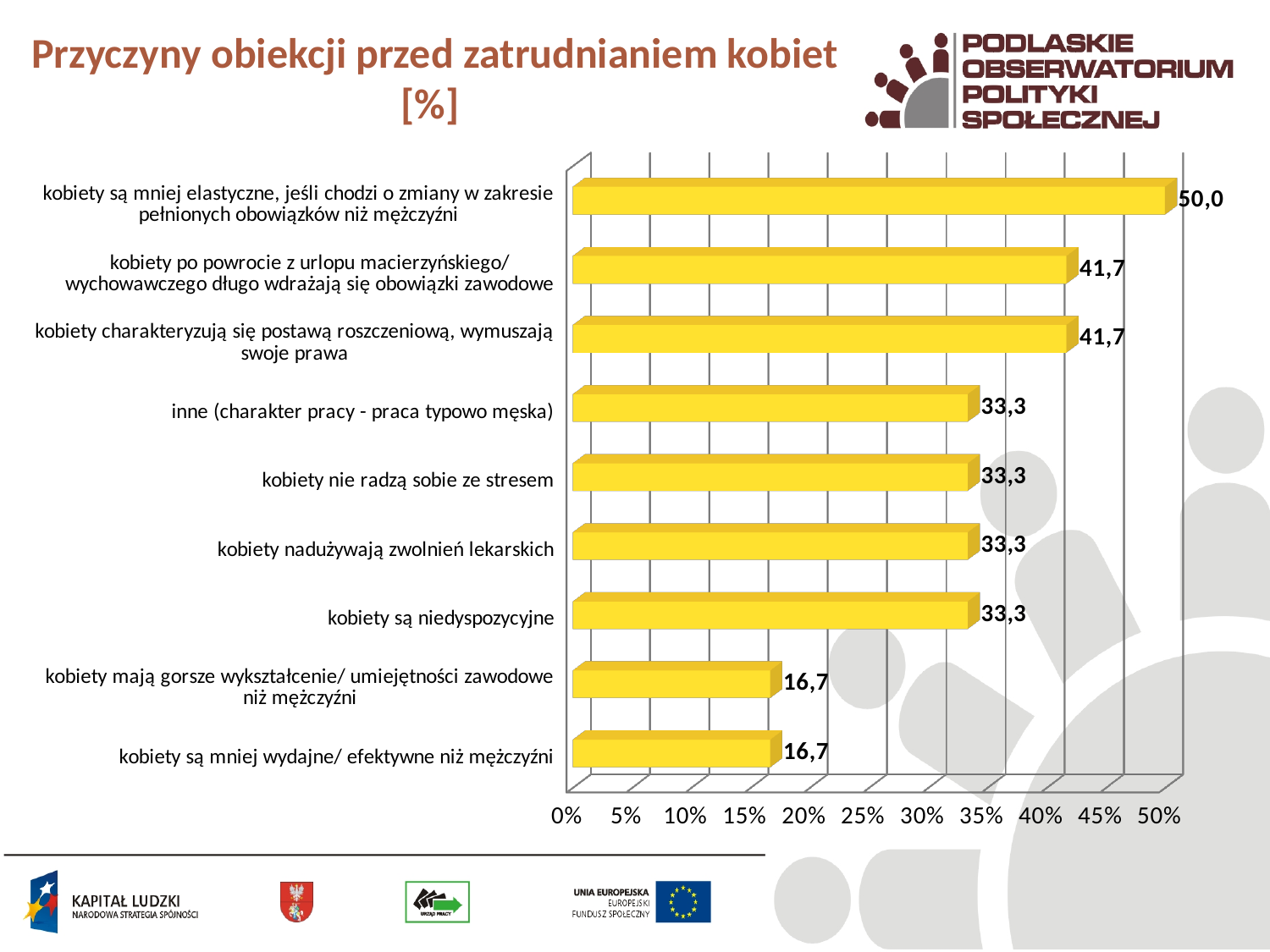
What is the value for "kobiety nie radzą sobie ze stresem"? 33,3 How many categories are shown in the chart? 9 What kind of chart is shown on the slide? bar chart Which is larger: the value for "inne (charakter pracy - praca typowo męska)" or the value for "kobiety są mniej wydajne/ efektywne niż mężczyźni"? inne (charakter pracy - praca typowo męska) Which category has the highest value? kobiety są mniej elastyczne, jeśli chodzi o zmiany w zakresie pełnionych obowiązków niż mężczyźni What is the difference between the value for "kobiety po powrocie z urlopu macierzyńskiego/ wychowawczego długo wdrażają się obowiązki zawodowe" and the value for "kobiety mają gorsze wykształcenie/ umiejętności zawodowe niż mężczyźni"? 25,0 What is the value for "kobiety są mniej elastyczne, jeśli chodzi o zmiany w zakresie pełnionych obowiązków niż mężczyźni"? 50,0 What is the difference between the value for "kobiety są mniej elastyczne, jeśli chodzi o zmiany w zakresie pełnionych obowiązków niż mężczyźni" and the value for "kobiety są niedyspozycyjne"? 16,7 Is the value for "kobiety nadużywają zwolnień lekarskich" greater or less than 30%? greater What is the value for "kobiety charakteryzują się postawą roszczeniową, wymuszają swoje prawa"? 41,7 What is the value for "kobiety są mniej wydajne/ efektywne niż mężczyźni"? 16,7 What is the title of the chart? Przyczyny obiekcji przed zatrudnianiem kobiet [%]